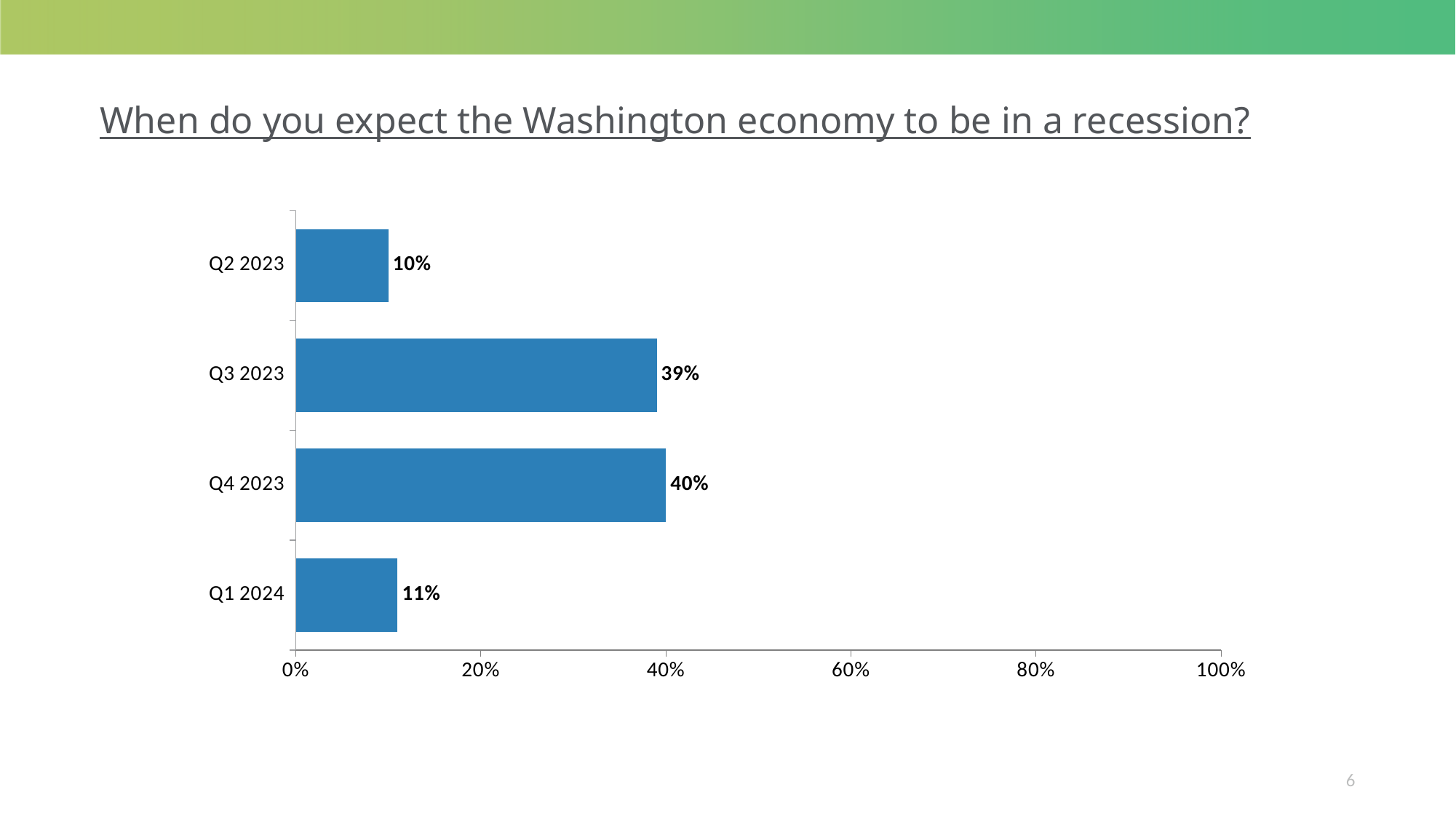
What is the value shown for Q4 2023? 40% Is the value for Q3 2023 greater or less than 20%? greater Which quarter has the lowest value on the chart? Q2 2023 What is the difference between the values for Q1 2024 and Q2 2023? 1% What kind of chart is shown on the slide? Bar chart Which quarter has the highest value on the chart? Q4 2023 How many quarters are shown on the chart? 4 What is the value shown for Q1 2024? 11% Which has a larger value, Q3 2023 or Q1 2024? Q3 2023 What is the difference between the values for Q4 2023 and Q2 2023? 30% What percentage of respondents expect the Washington economy to be in a recession in Q3 2023? 39% What is the value shown for Q2 2023? 10%